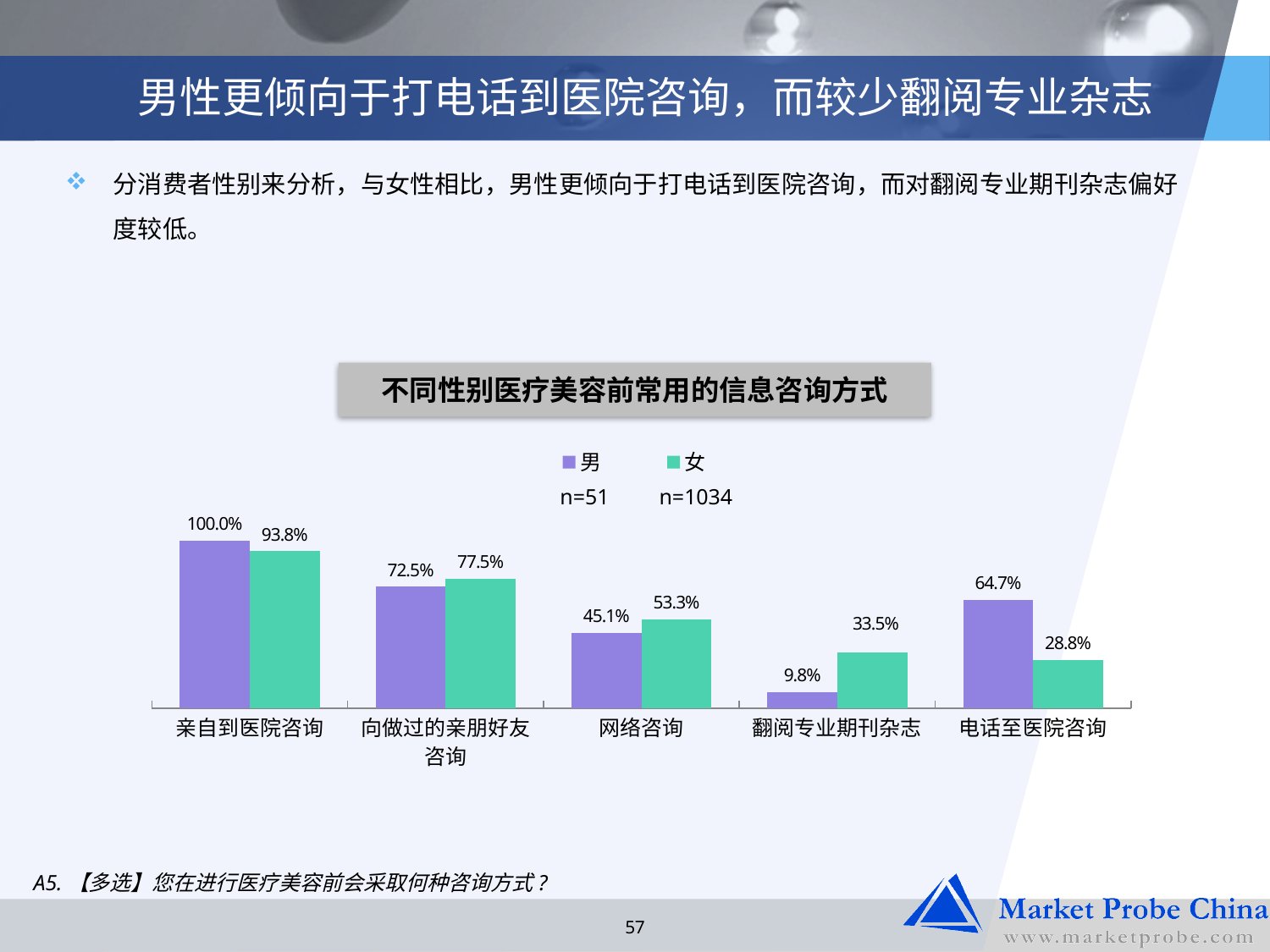
What is the value for 男 in the 电话至医院咨询 category? 64.7% What is the difference between 男 and 女 in the 电话至医院咨询 category? 35.9% How many categories are shown on the x axis? 5 What is the value for 女 in the 网络咨询 category? 53.3% Which category has the highest value for 女? 亲自到医院咨询 What is the value for 男 in the 亲自到医院咨询 category? 100.0% What type of chart is shown on the slide? Bar chart What is the difference between 女 and 男 in the 翻阅专业期刊杂志 category? 23.7% In the 向做过的亲朋好友咨询 category, which is larger, 男 or 女? 女 How many series does the legend list? 2 What is the value for 女 in the 翻阅专业期刊杂志 category? 33.5% Which category has the lowest value for 男? 翻阅专业期刊杂志